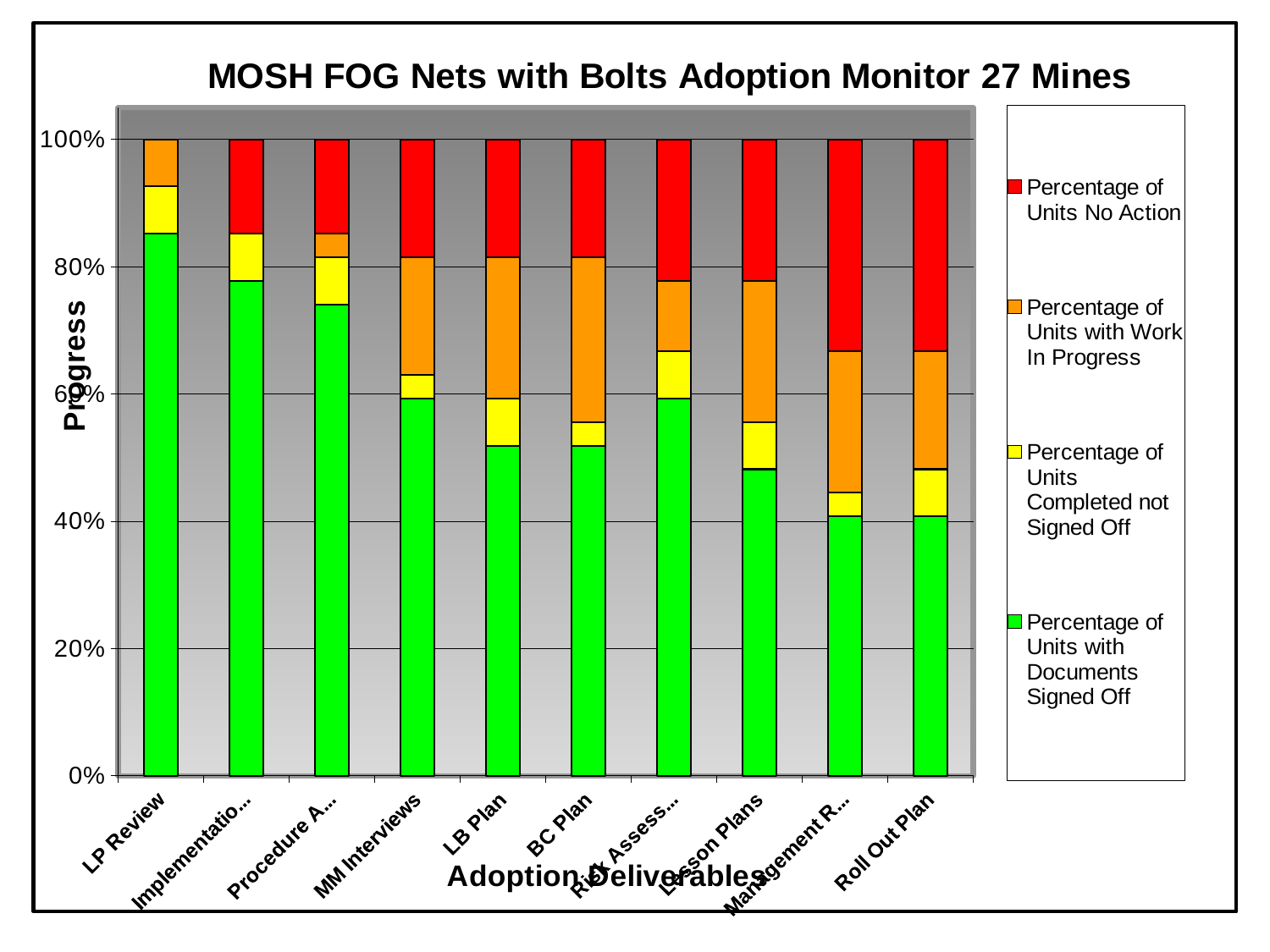
How many series does the legend list? 4 Is the 'Percentage of Units with Documents Signed Off' value for LP Review greater or less than 80%? greater Is the 'Percentage of Units with Documents Signed Off' value for LB Plan greater or less than 60%? less Which category has the highest value for 'Percentage of Units with Documents Signed Off'? LP Review What kind of chart is shown on the slide? stacked bar chart Which colour represents 'Percentage of Units No Action' in the legend? red Is the 'Percentage of Units with Documents Signed Off' value for Lesson Plans greater or less than 40%? greater Which has the larger 'Percentage of Units with Documents Signed Off' value, LP Review or Lesson Plans? LP Review What is the total of the stacked bar for Roll Out Plan? 100% What is the title of the chart? MOSH FOG Nets with Bolts Adoption Monitor 27 Mines How many categories are shown along the x axis? 10 Does the 'Percentage of Units with Documents Signed Off' series generally rise or fall from left to right along the x axis? fall